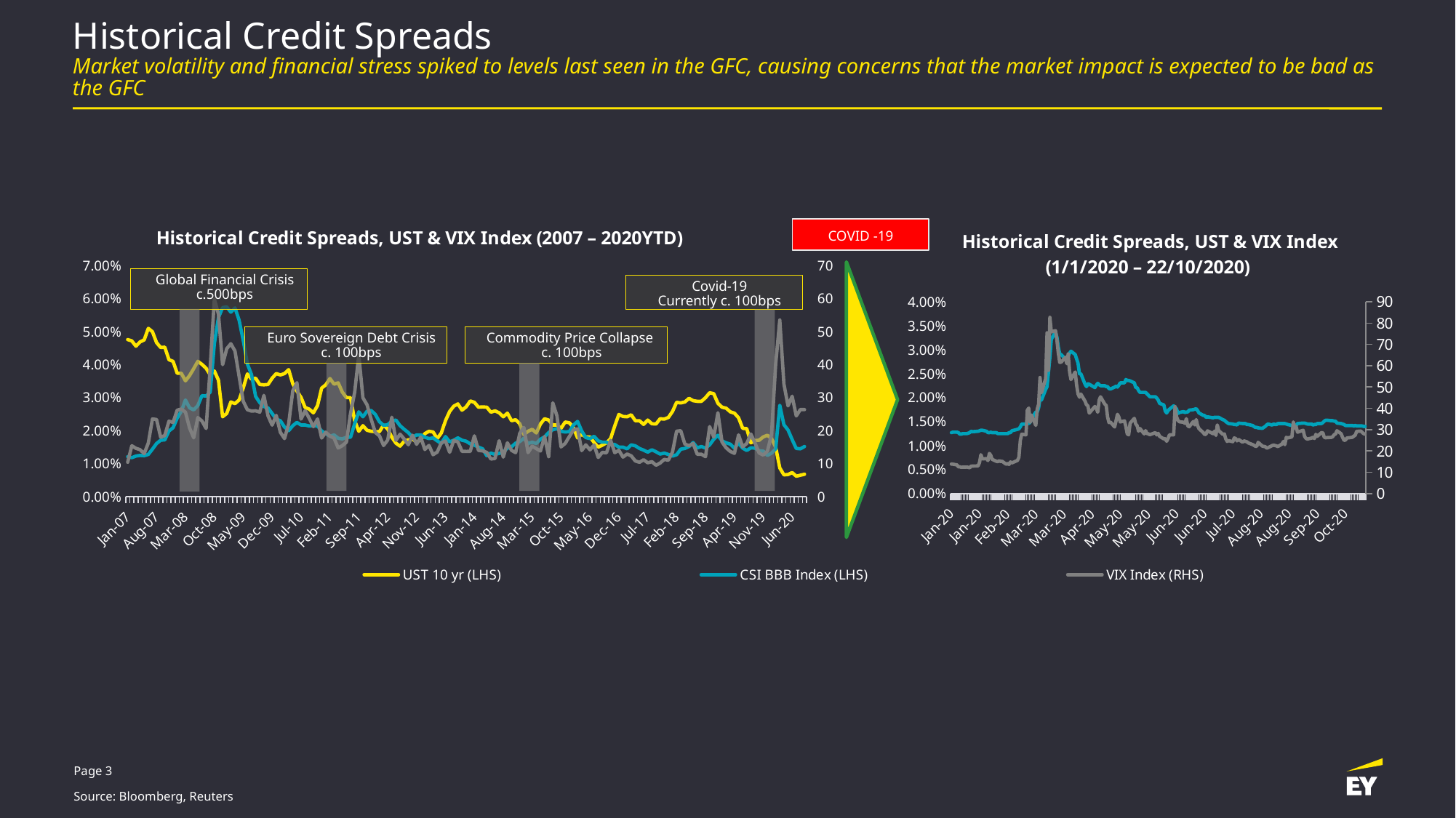
In the right chart (1/1/2020 – 22/10/2020), is the peak value of the CSI BBB Index in Mar-20 greater or less than 3.00%? greater In the right chart (1/1/2020 – 22/10/2020), is the VIX Index higher in Mar-20 or in Oct-20? Mar-20 How many series does the legend at the bottom of the slide list? 3 In the left chart (2007 – 2020YTD), is the value of UST 10 yr at Jan-07 greater or less than 4.00%? greater In the right chart (1/1/2020 – 22/10/2020), is the peak value of the VIX Index in Mar-20 greater or less than 70? greater What is the maximum value shown on the right-hand axis of the right chart (1/1/2020 – 22/10/2020)? 90 What kind of chart is the left chart, 'Historical Credit Spreads, UST & VIX Index (2007 – 2020YTD)'? Line chart In the right chart (1/1/2020 – 22/10/2020), does the CSI BBB Index rise or fall from Mar-20 to Oct-20? Fall In the left chart (2007 – 2020YTD), which crisis is annotated as 'c.500bps'? Global Financial Crisis In the left chart (2007 – 2020YTD), which of the two LHS series reaches the higher peak, UST 10 yr or CSI BBB Index? CSI BBB Index In the left chart (2007 – 2020YTD), does the UST 10 yr series overall rise or fall from Jan-07 to Jun-20? Fall